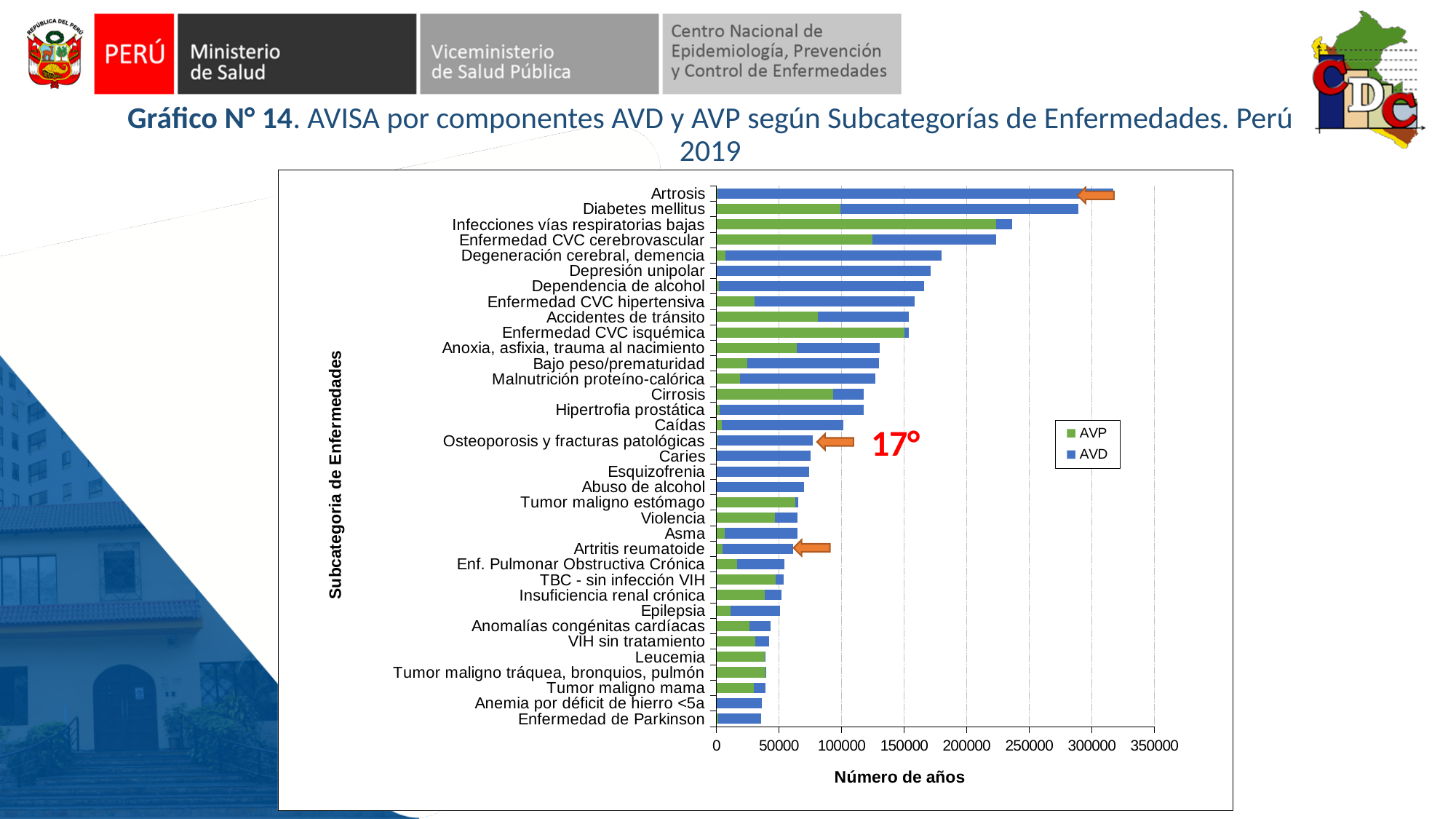
Which has a larger total value, Caries or Artrosis? Artrosis Is the total value for Osteoporosis y fracturas patológicas greater or less than 100000? less How many series does the legend list? 2 What is the title of the horizontal axis? Número de años Which colour represents the AVP series in the legend? Green Is the total value for Enfermedad de Parkinson greater or less than 50000? less Which has a larger total value, Diabetes mellitus or Cirrosis? Diabetes mellitus Is the total value for Degeneración cerebral, demencia greater or less than 150000? greater What kind of chart is shown on the slide? Bar chart Which disease subcategory has the highest total number of years (AVISA)? Artrosis How many disease subcategories are plotted on the chart? 35